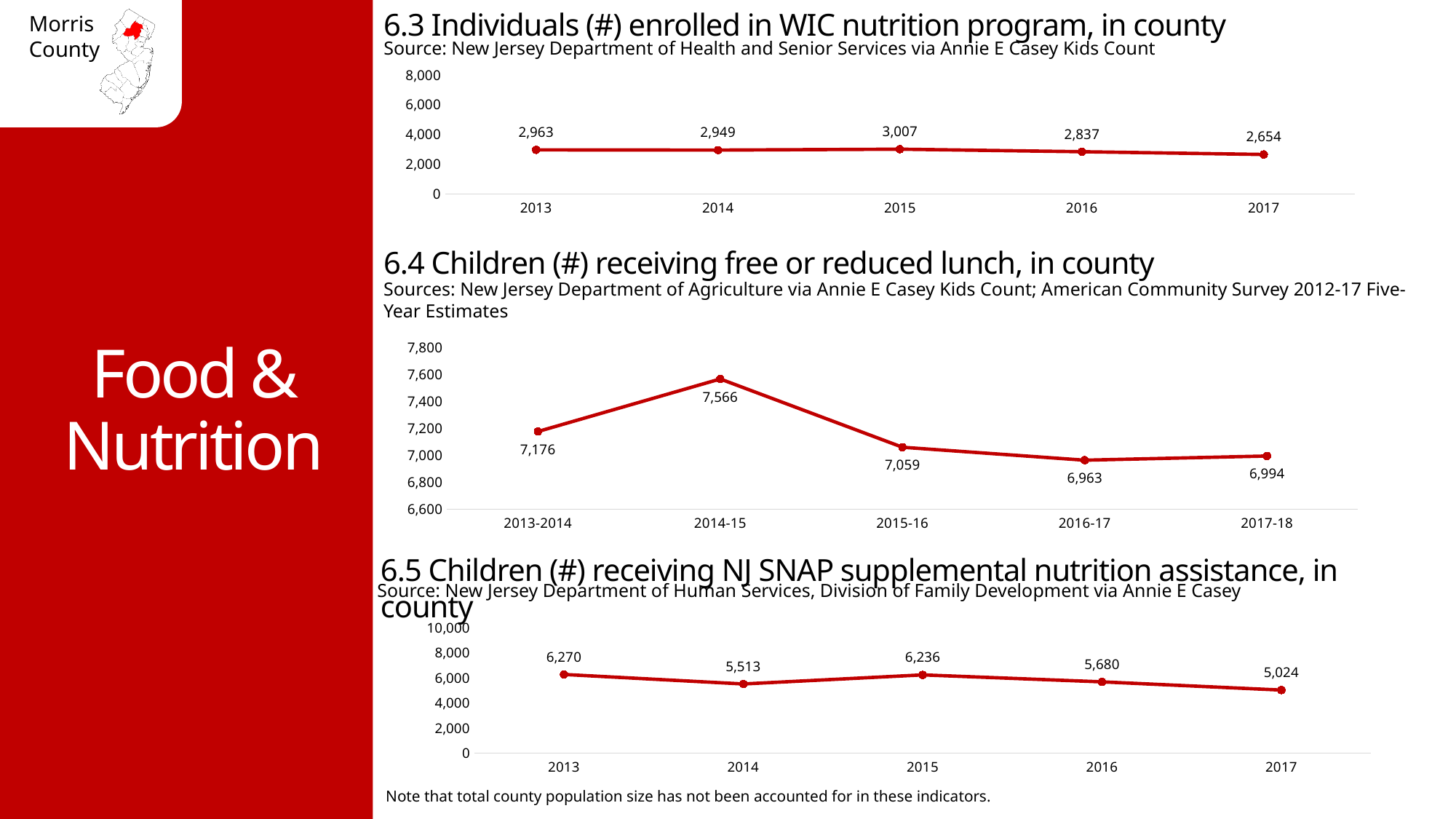
In the chart '6.4 Children (#) receiving free or reduced lunch, in county', what is the difference between the 2014-15 and 2015-16 values? 507 In the chart '6.3 Individuals (#) enrolled in WIC nutrition program, in county', how many data points are plotted? 5 In the chart '6.3 Individuals (#) enrolled in WIC nutrition program, in county', what is the value for 2015? 3,007 In the chart '6.3 Individuals (#) enrolled in WIC nutrition program, in county', which year has the lowest value? 2017 In the chart '6.3 Individuals (#) enrolled in WIC nutrition program, in county', what is the difference between the 2013 and 2017 values? 309 In the chart '6.5 Children (#) receiving NJ SNAP supplemental nutrition assistance, in county', what is the difference between the 2013 and 2017 values? 1,246 In the chart '6.4 Children (#) receiving free or reduced lunch, in county', which school year has the lowest value? 2016-17 What kind of chart is '6.4 Children (#) receiving free or reduced lunch, in county'? Line chart In the chart '6.5 Children (#) receiving NJ SNAP supplemental nutrition assistance, in county', what is the value for 2016? 5,680 In the chart '6.4 Children (#) receiving free or reduced lunch, in county', what is the value for 2014-15? 7,566 In the chart '6.5 Children (#) receiving NJ SNAP supplemental nutrition assistance, in county', which year has the highest value? 2013 In the chart '6.4 Children (#) receiving free or reduced lunch, in county', which is larger, the value for 2013-2014 or the value for 2017-18? 2013-2014